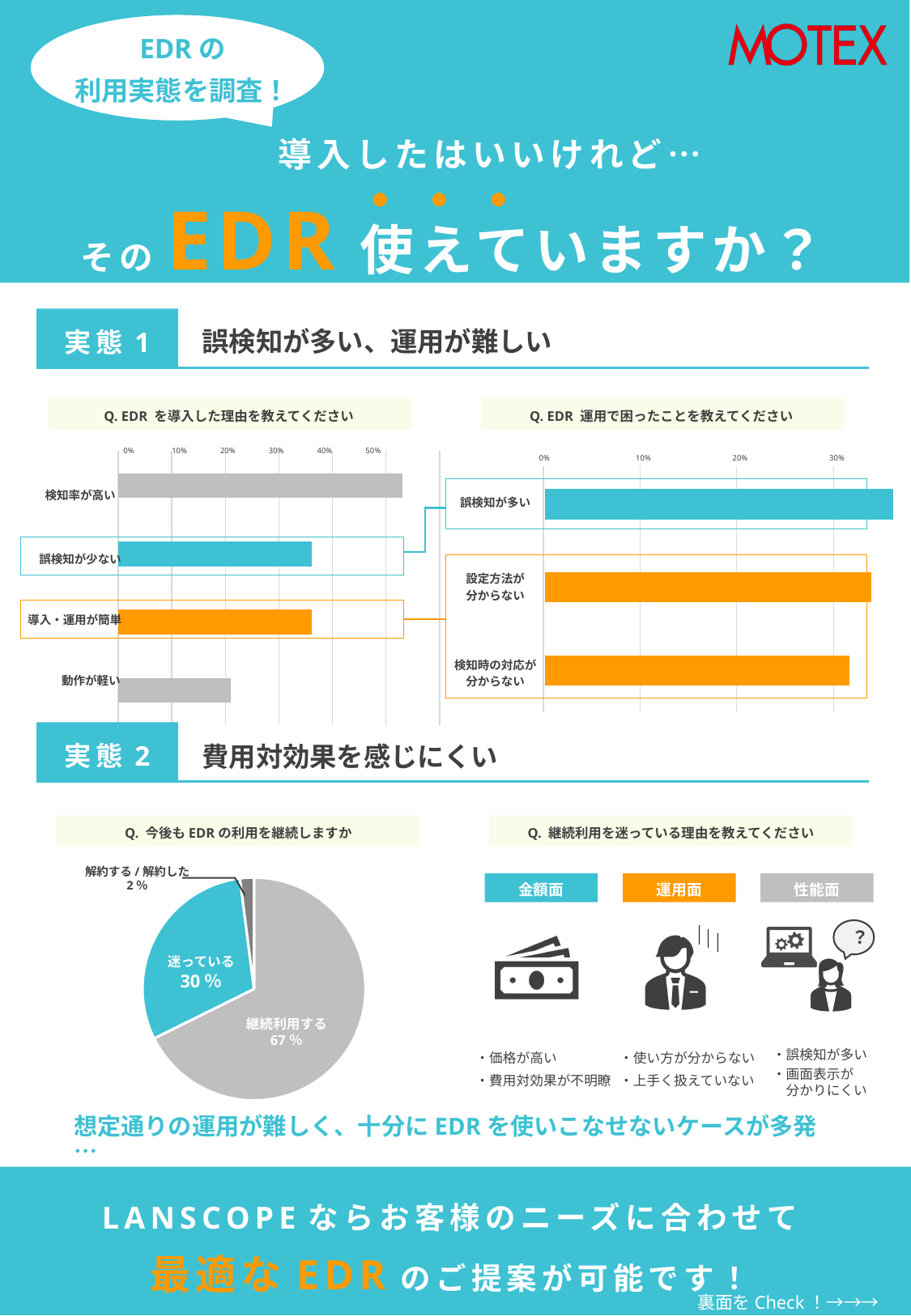
In the chart "Q. EDR を導入した理由を教えてください", is the value for 検知率が高い greater or less than 50%? greater In the pie chart "Q. 今後も EDR の利用を継続しますか", what percentage of respondents answered 継続利用する? 67% In the chart "Q. EDR を導入した理由を教えてください", which reason has the lowest value? 動作が軽い How many slices does the pie chart "Q. 今後も EDR の利用を継続しますか" have? 3 In the chart "Q. EDR を導入した理由を教えてください", which reason has the highest value? 検知率が高い In the chart "Q. EDR 運用で困ったことを教えてください", which item has the highest value? 誤検知が多い In the pie chart "Q. 今後も EDR の利用を継続しますか", what percentage is shown for 解約する / 解約した? 2% In the pie chart "Q. 今後も EDR の利用を継続しますか", what is the difference in percentage points between 継続利用する and 迷っている? 37 In the pie chart "Q. 今後も EDR の利用を継続しますか", what share is shown for 迷っている? 30% What type of chart is "Q. EDR を導入した理由を教えてください"? Bar chart How many categories are shown in the chart "Q. EDR 運用で困ったことを教えてください"? 3 In the pie chart "Q. 今後も EDR の利用を継続しますか", which slice is the largest? 継続利用する